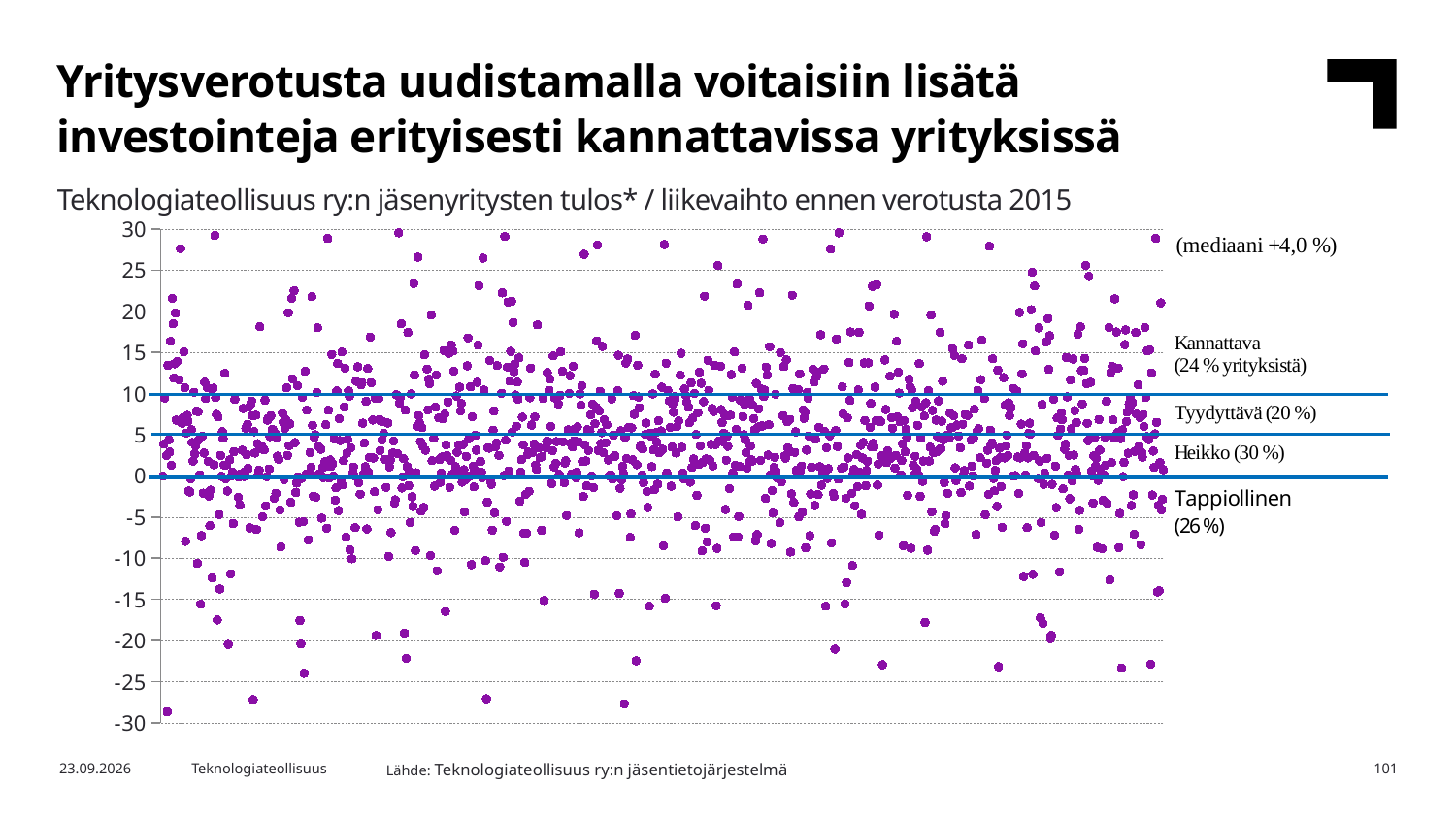
What is the title of the chart? Teknologiateollisuus ry:n jäsenyritysten tulos* / liikevaihto ennen verotusta 2015 Which category has the smallest share of companies: Kannattava, Tyydyttävä, Heikko or Tappiollinen? Tyydyttävä What share of companies is labelled as Tappiollinen on the chart? 26 % What share of companies is labelled as Tyydyttävä on the chart? 20 % Which category has the largest share of companies: Kannattava, Tyydyttävä, Heikko or Tappiollinen? Heikko What are the highest and lowest values shown on the vertical axis? 30 and -30 What is the difference between the share of Heikko companies and the share of Tyydyttävä companies? 10 percentage points What kind of chart is shown on the slide? Scatter plot What median value is stated on the chart? +4,0 % What share of companies is labelled as Kannattava on the chart? 24 % Is the share of Tappiollinen companies larger or smaller than the share of Kannattava companies? Larger What share of companies is labelled as Heikko on the chart? 30 %